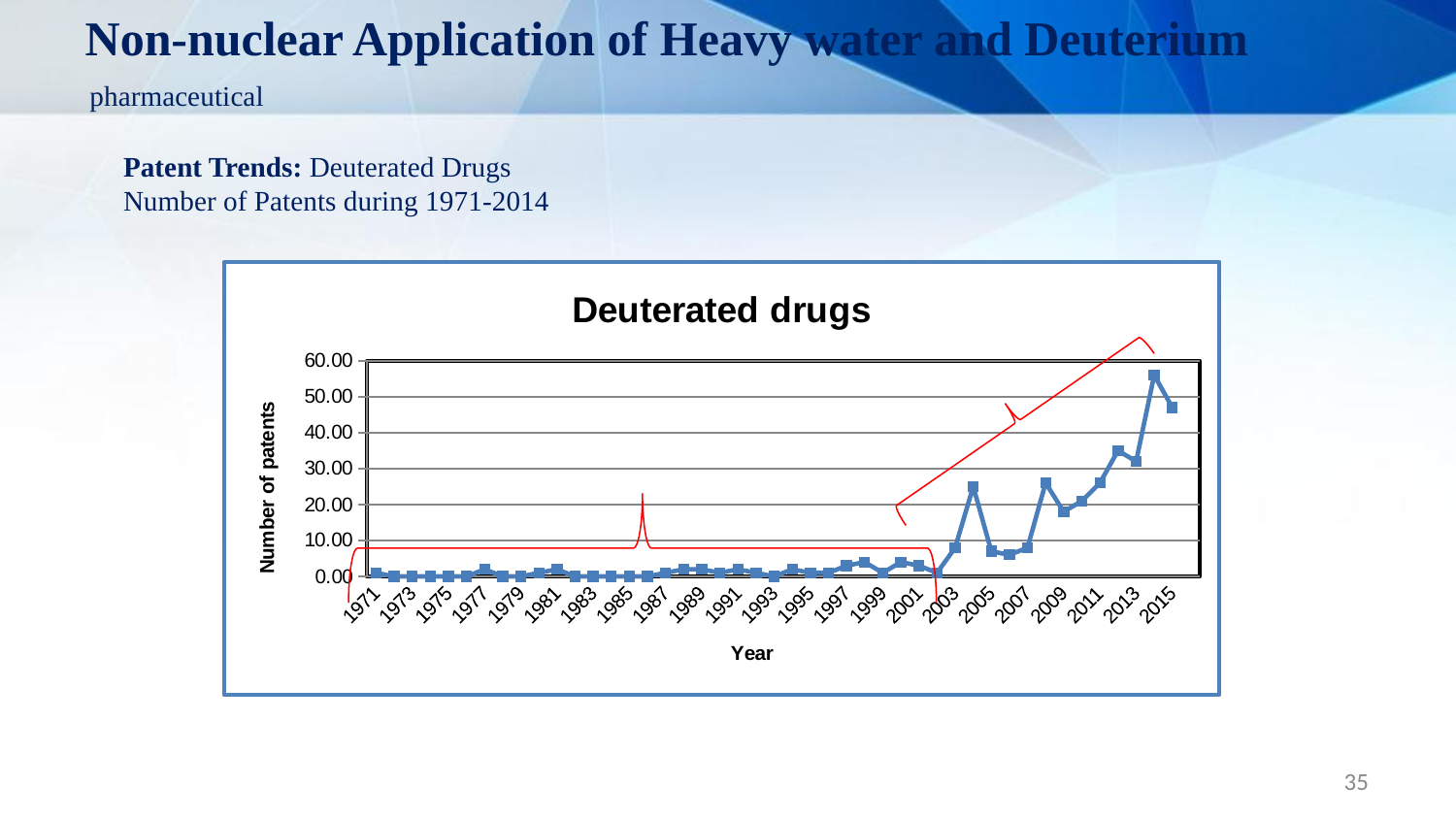
What is the title of the chart? Deuterated drugs Is the value for 2001 greater or less than 10.00? less Is the value for 1971 greater or less than 10.00? less Is the value for 1991 greater or less than 10.00? less What kind of chart is shown on the slide? line chart What is the label of the vertical axis of the chart? Number of patents Which is larger, the value for 1975 or the highest value after 2010? the highest value after 2010 Overall, do the number of patents rise or fall from 1971 to 2015? rise